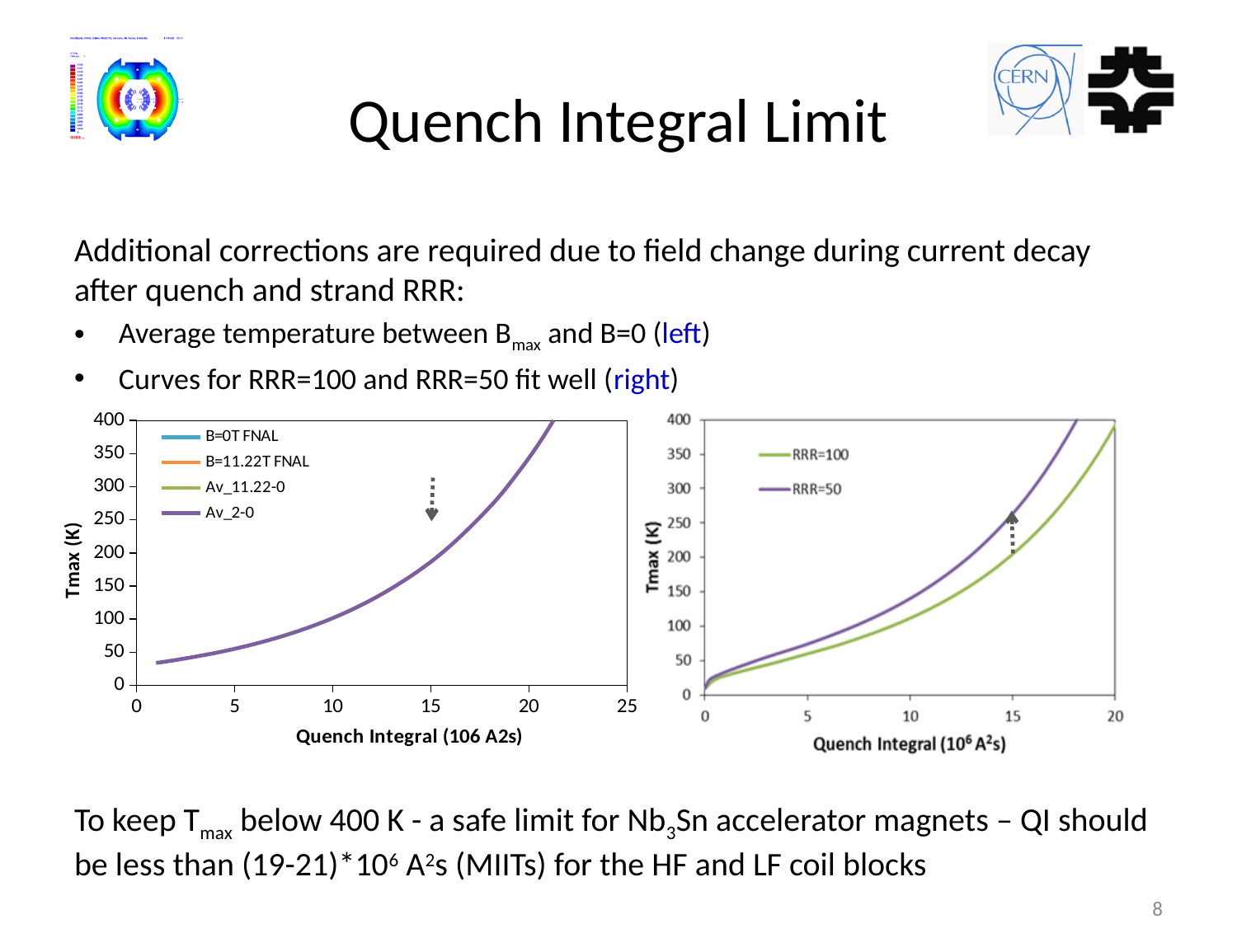
In the left chart, is the Tmax value at a quench integral of 15 greater or less than 200? less How many series does the legend of the left chart list? 4 What are the legend entries of the right chart? RRR=100 and RRR=50 In the left chart, is the Tmax value at a quench integral of 20 greater or less than 300? greater In the right chart, is the Tmax value for RRR=50 at a quench integral of 15 greater or less than 200? greater In the right chart, does Tmax rise or fall as the quench integral increases? rise What is the y-axis label of the left chart? Tmax (K) What kind of chart is the right chart? line chart How many series does the legend of the right chart list? 2 In the right chart, which series has the higher Tmax at a quench integral of 15? RRR=50 What kind of chart is the left chart? line chart